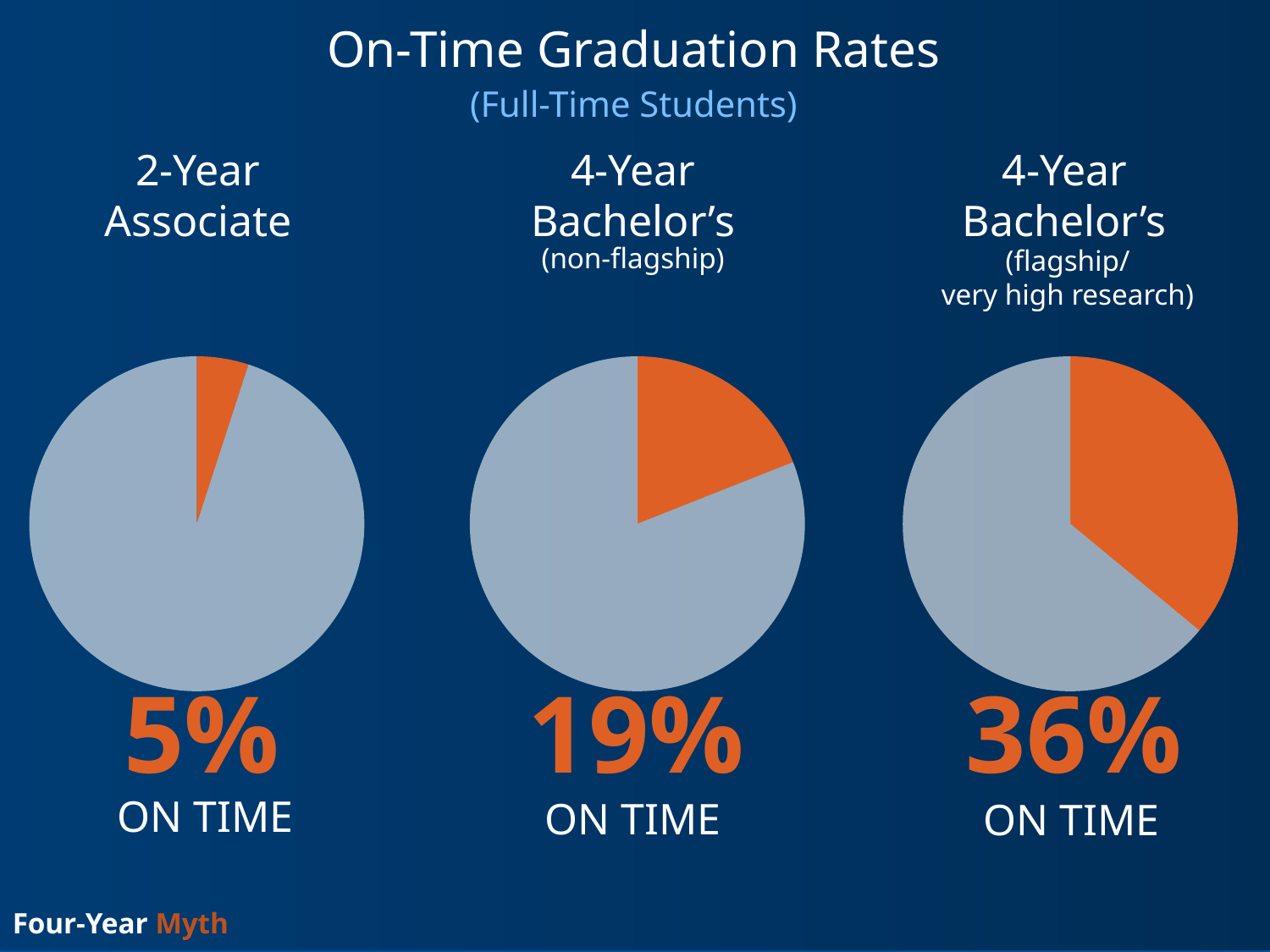
What is the title of the slide's charts? On-Time Graduation Rates (Full-Time Students) How many pie charts are shown on the slide? 3 What is the difference in on-time graduation rate between the 4-Year Bachelor's (non-flagship) chart and the 2-Year Associate chart? 14% What is the difference in on-time graduation rate between the 4-Year Bachelor's (flagship/very high research) chart and the 4-Year Bachelor's (non-flagship) chart? 17% Which of the three pie charts shows the highest on-time graduation rate? 4-Year Bachelor's (flagship/very high research) On the 2-Year Associate pie chart, what percentage of full-time students graduate on time? 5% What kind of charts are shown on the slide? Pie charts On the 4-Year Bachelor's (non-flagship) pie chart, what percentage of full-time students graduate on time? 19% Which has a higher on-time graduation rate: the 2-Year Associate chart or the 4-Year Bachelor's (non-flagship) chart? 4-Year Bachelor's (non-flagship) Which of the three pie charts shows the lowest on-time graduation rate? 2-Year Associate On the 4-Year Bachelor's (flagship/very high research) pie chart, what percentage of full-time students graduate on time? 36% On the 4-Year Bachelor's (flagship/very high research) pie chart, what share of the pie does the orange slice represent? 36%